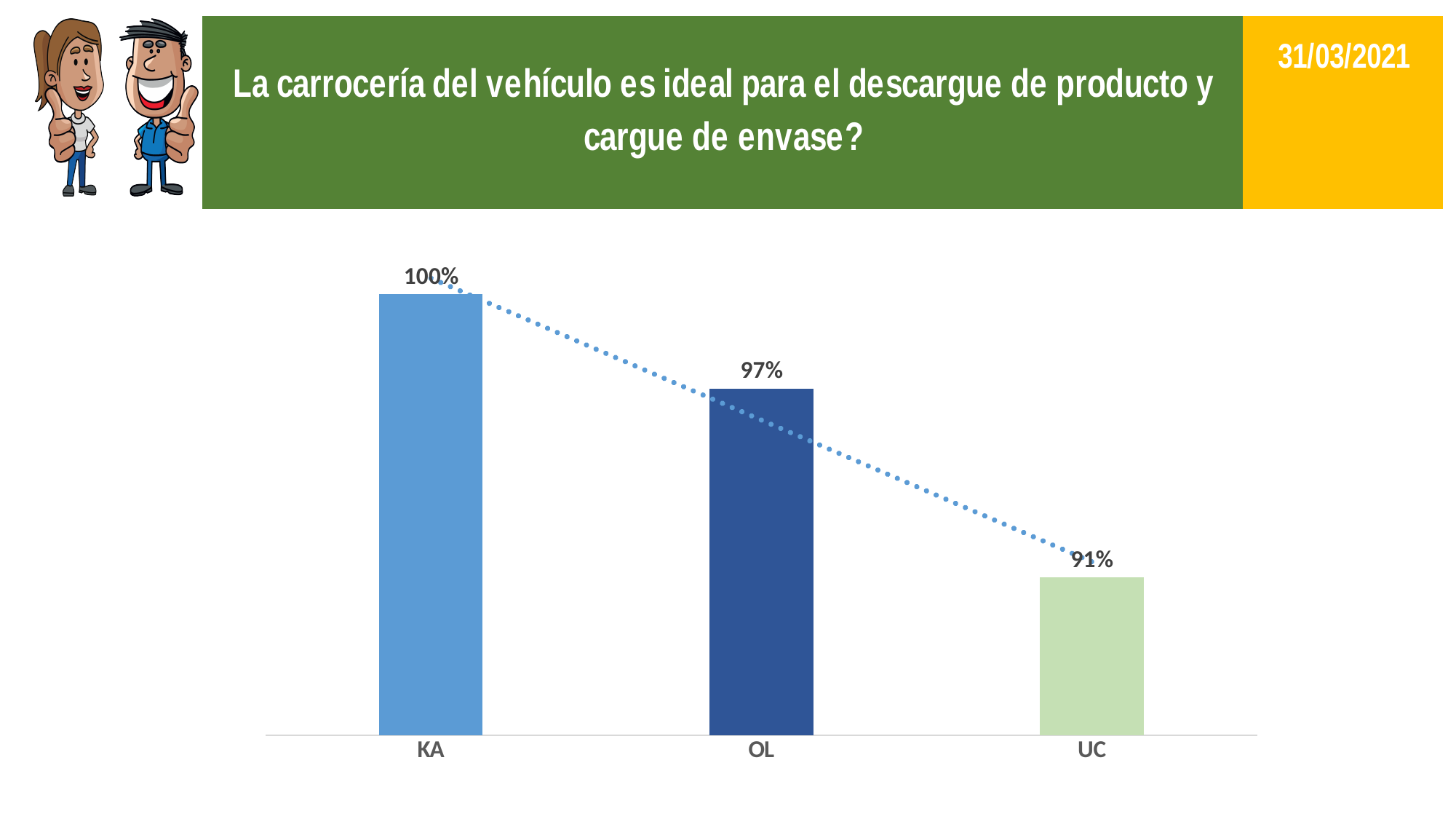
Which category has the lowest value? UC What is the difference between the values for OL and UC? 6% Which category has the highest value? KA What is the value for KA? 100% What date is shown in the top right corner of the slide? 31/03/2021 What is the difference between the values for KA and UC? 9% Which is larger, the value for OL or the value for UC? OL Do the values rise or fall from KA to UC along the x axis? Fall What kind of chart is shown on the slide? Bar chart What is the value for UC? 91% How many categories are shown on the x axis? 3 What is the value for OL? 97%